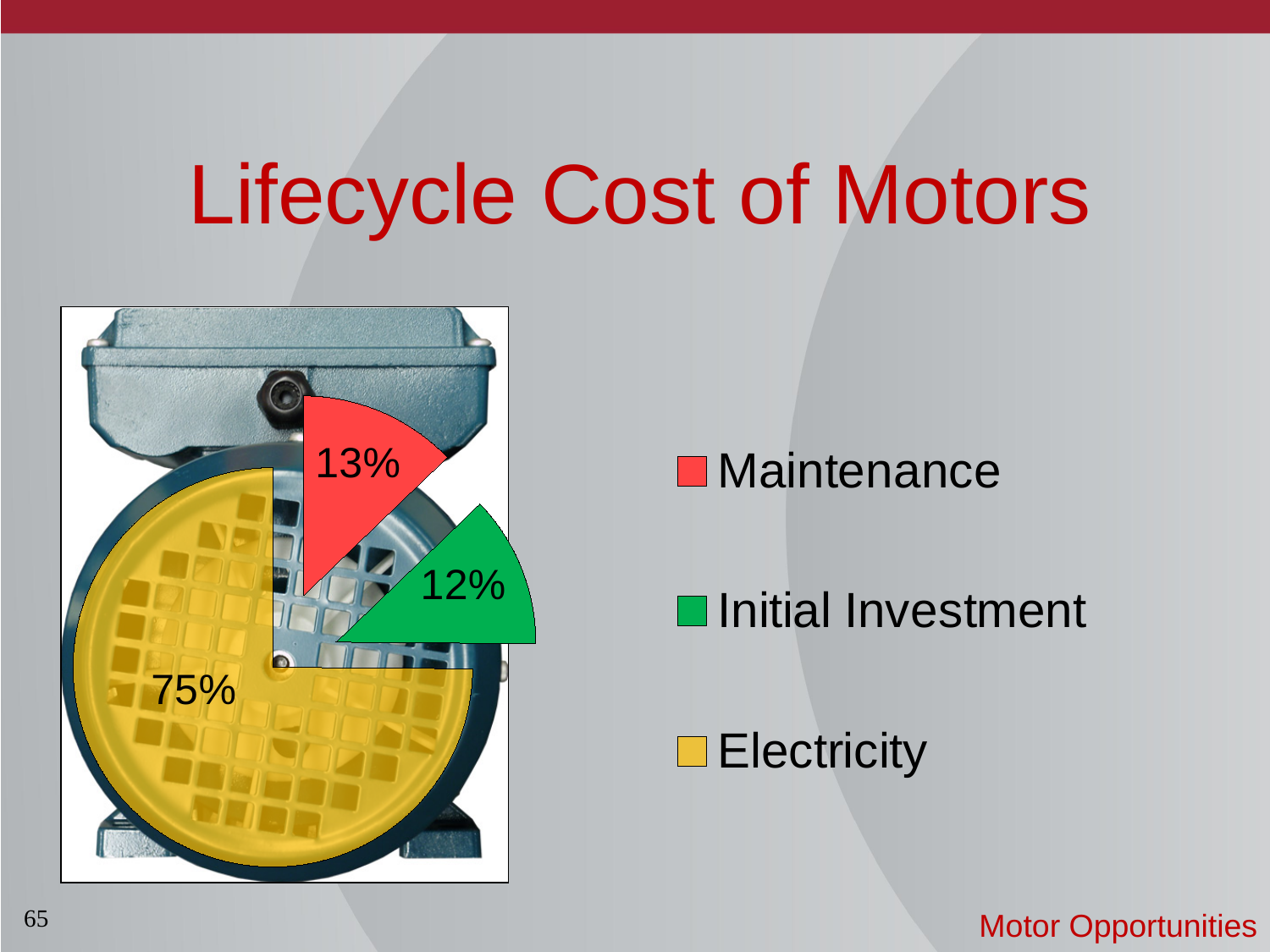
What share of the lifecycle cost is Electricity? 75% What is the title of the slide containing the chart? Lifecycle Cost of Motors Which colour represents Initial Investment in the pie chart? green What is the difference in percentage points between the Electricity share and the Maintenance share? 62 What is the difference in percentage points between the Maintenance share and the Initial Investment share? 1 How many entries does the legend list? 3 Which category has the smallest share of the lifecycle cost? Initial Investment Which category has the largest share of the lifecycle cost? Electricity What share of the lifecycle cost is Maintenance? 13% What share of the lifecycle cost is Initial Investment? 12% How many slices does the pie chart have? 3 What kind of chart is shown on the slide? pie chart